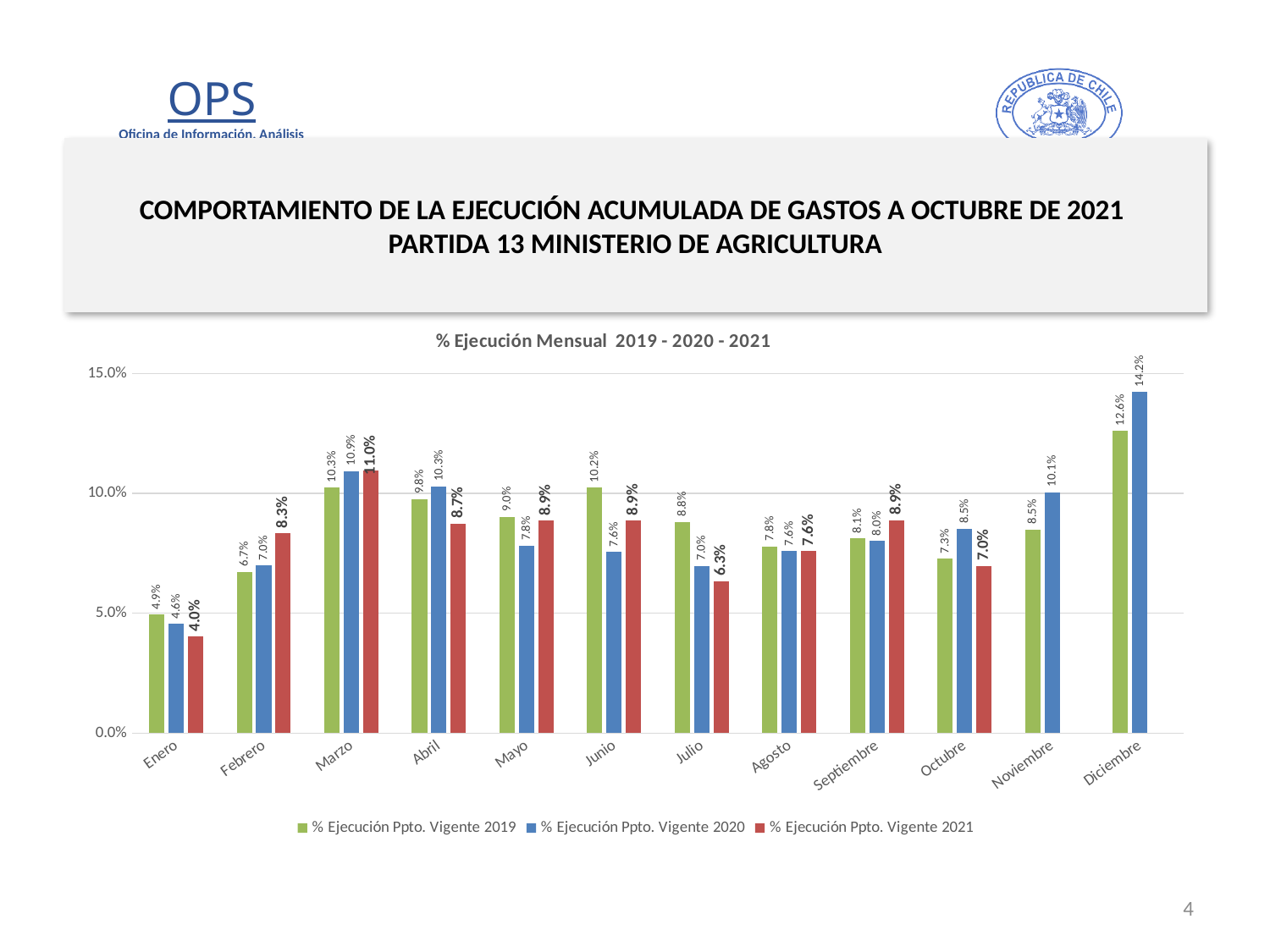
How many months are shown on the x axis? 12 Which month has the lowest % Ejecución Ppto. Vigente 2021 value? Enero What is the % Ejecución Ppto. Vigente 2021 value for Marzo? 11.0% What is the % Ejecución Ppto. Vigente 2019 value for Diciembre? 12.6% Which is larger for Julio: the 2019 value or the 2021 value? 2019 value What is the % Ejecución Ppto. Vigente 2020 value for Noviembre? 10.1% What kind of chart is shown on the slide? Bar chart Is the % Ejecución Ppto. Vigente 2020 value for Diciembre greater or less than 10.0%? greater What is the difference between the 2020 and 2019 values for Diciembre? 1.6% How many series does the legend list? 3 What is the title of the chart? % Ejecución Mensual 2019 - 2020 - 2021 Which month has the highest % Ejecución Ppto. Vigente 2020 value? Diciembre